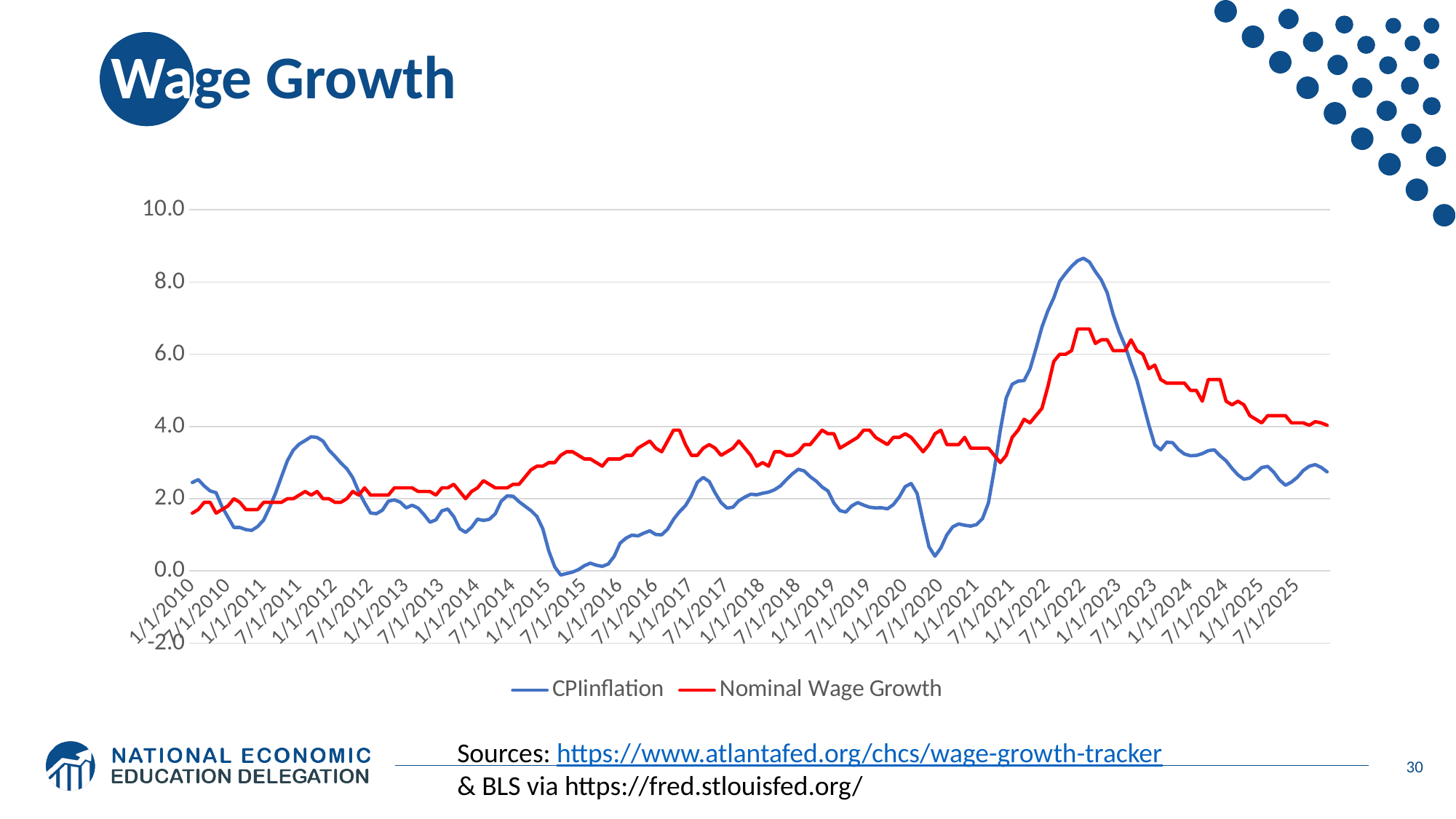
Is the peak value of CPI inflation around 7/1/2022 greater or less than 8.0? greater Is the peak value of Nominal Wage Growth around 7/1/2022 greater or less than 6.0? greater What colour is the Nominal Wage Growth line? Red What are the two series named in the legend? CPIinflation and Nominal Wage Growth How many series does the legend list? 2 At 7/1/2022, which series has the higher value, CPI inflation or Nominal Wage Growth? CPIinflation Does CPI inflation rise or fall between 7/1/2022 and 7/1/2023? Fall Is the CPI inflation value at 7/1/2015 greater or less than 2.0? less What kind of chart is shown on the slide? Line chart At 1/1/2024, which series has the higher value, CPI inflation or Nominal Wage Growth? Nominal Wage Growth Which series reaches the highest value anywhere on the chart? CPIinflation